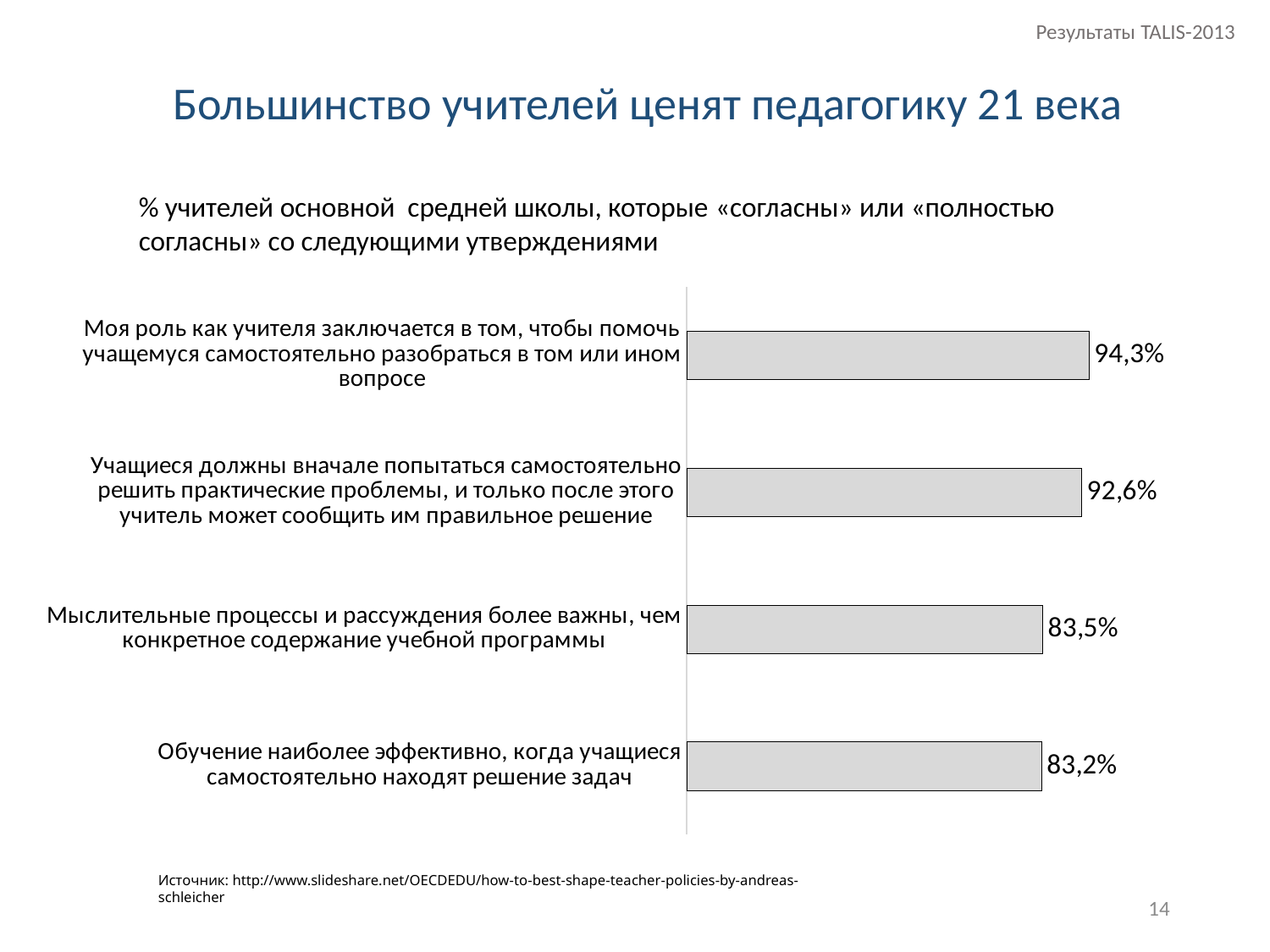
What is the difference between the highest value (94,3%) and the lowest value (83,2%) on the chart? 11,1% How many statements (bars) are shown on the chart? 4 What is the title of the slide containing the chart? Большинство учителей ценят педагогику 21 века What value is shown for the statement «Обучение наиболее эффективно, когда учащиеся самостоятельно находят решение задач»? 83,2% Which is larger: the value for «Учащиеся должны вначале попытаться самостоятельно решить практические проблемы...» or the value for «Мыслительные процессы и рассуждения более важны...»? Учащиеся должны вначале попытаться самостоятельно решить практические проблемы... Which statement has the lowest percentage of agreement? Обучение наиболее эффективно, когда учащиеся самостоятельно находят решение задач What percentage of teachers agree with the statement «Моя роль как учителя заключается в том, чтобы помочь учащемуся самостоятельно разобраться в том или ином вопросе»? 94,3% What type of chart is shown on the slide? Bar chart What value is shown for the statement «Учащиеся должны вначале попытаться самостоятельно решить практические проблемы, и только после этого учитель может сообщить им правильное решение»? 92,6% What is the difference between the values for «Моя роль как учителя...» (94,3%) and «Учащиеся должны вначале попытаться...» (92,6%)? 1,7% What value is shown for the statement «Мыслительные процессы и рассуждения более важны, чем конкретное содержание учебной программы»? 83,5% Which statement has the highest percentage of agreement? Моя роль как учителя заключается в том, чтобы помочь учащемуся самостоятельно разобраться в том или ином вопросе